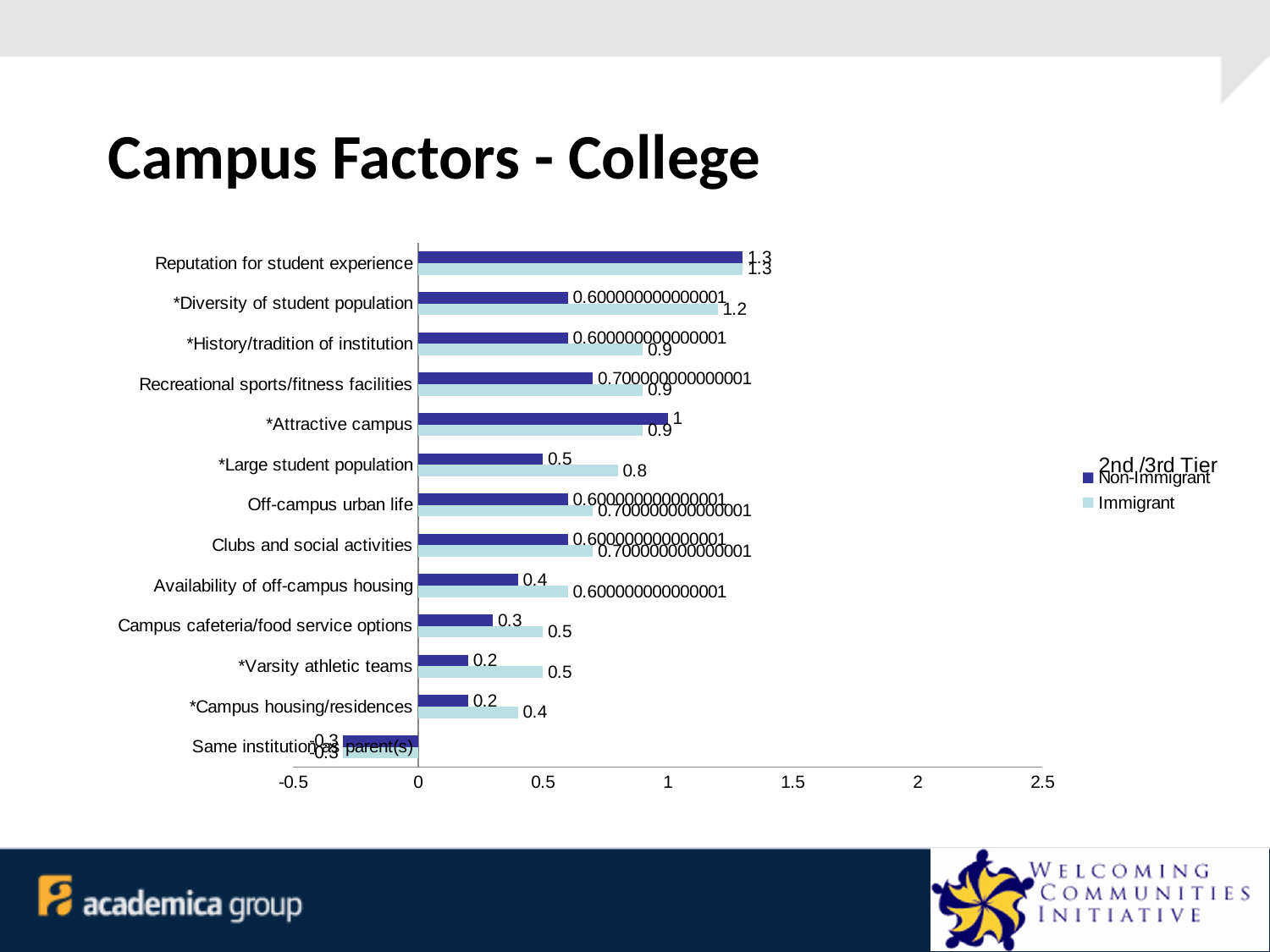
How many campus factor categories are plotted on the chart? 13 What is the Immigrant value for *Large student population? 0.8 What is the Immigrant value for *Diversity of student population? 1.2 For *Large student population, what is the difference between the Immigrant and Non-Immigrant values? 0.3 For *Varsity athletic teams, which series has the larger value, Non-Immigrant or Immigrant? Immigrant What title appears above the legend entries? 2nd /3rd Tier What is the Non-Immigrant value for *Attractive campus? 1 How many series does the legend list? 2 Which category has the highest Immigrant value? Reputation for student experience What is the Non-Immigrant value for Campus cafeteria/food service options? 0.3 What kind of chart is shown on the slide? bar chart For *Campus housing/residences, what is the difference between the Immigrant and Non-Immigrant values? 0.2